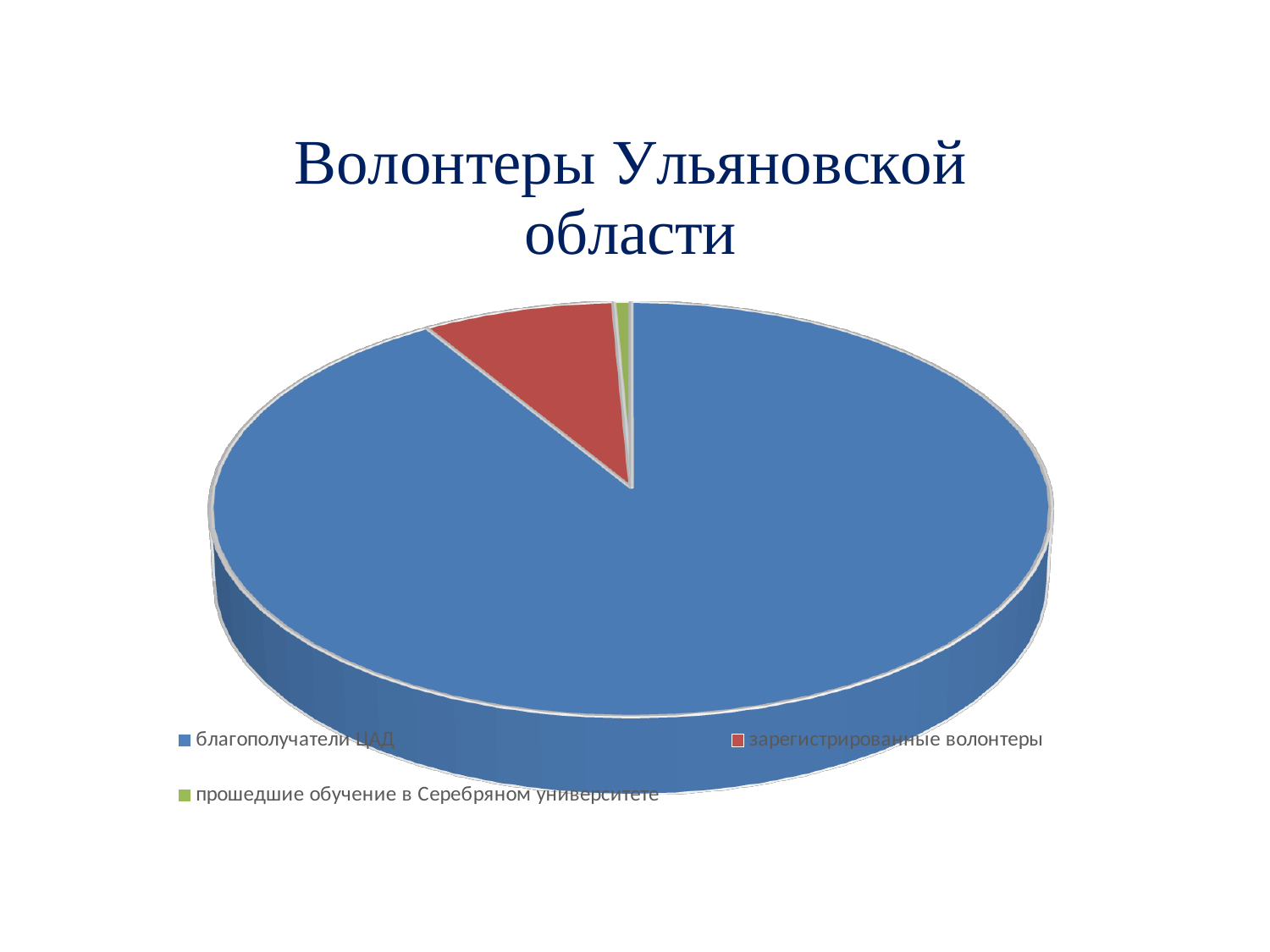
Which category has the smallest slice of the pie chart? прошедшие обучение в Серебряном университете Which slice is larger: зарегистрированные волонтеры or прошедшие обучение в Серебряном университете? зарегистрированные волонтеры What colour is the slice for зарегистрированные волонтеры? red How many entries does the legend of the pie chart list? 3 Which category has the largest slice of the pie chart? благополучатели ЦАД How many slices does the pie chart have? 3 Which slice is larger: благополучатели ЦАД or зарегистрированные волонтеры? благополучатели ЦАД What kind of chart is shown on the slide? pie chart What is the title of the slide with the pie chart? Волонтеры Ульяновской области